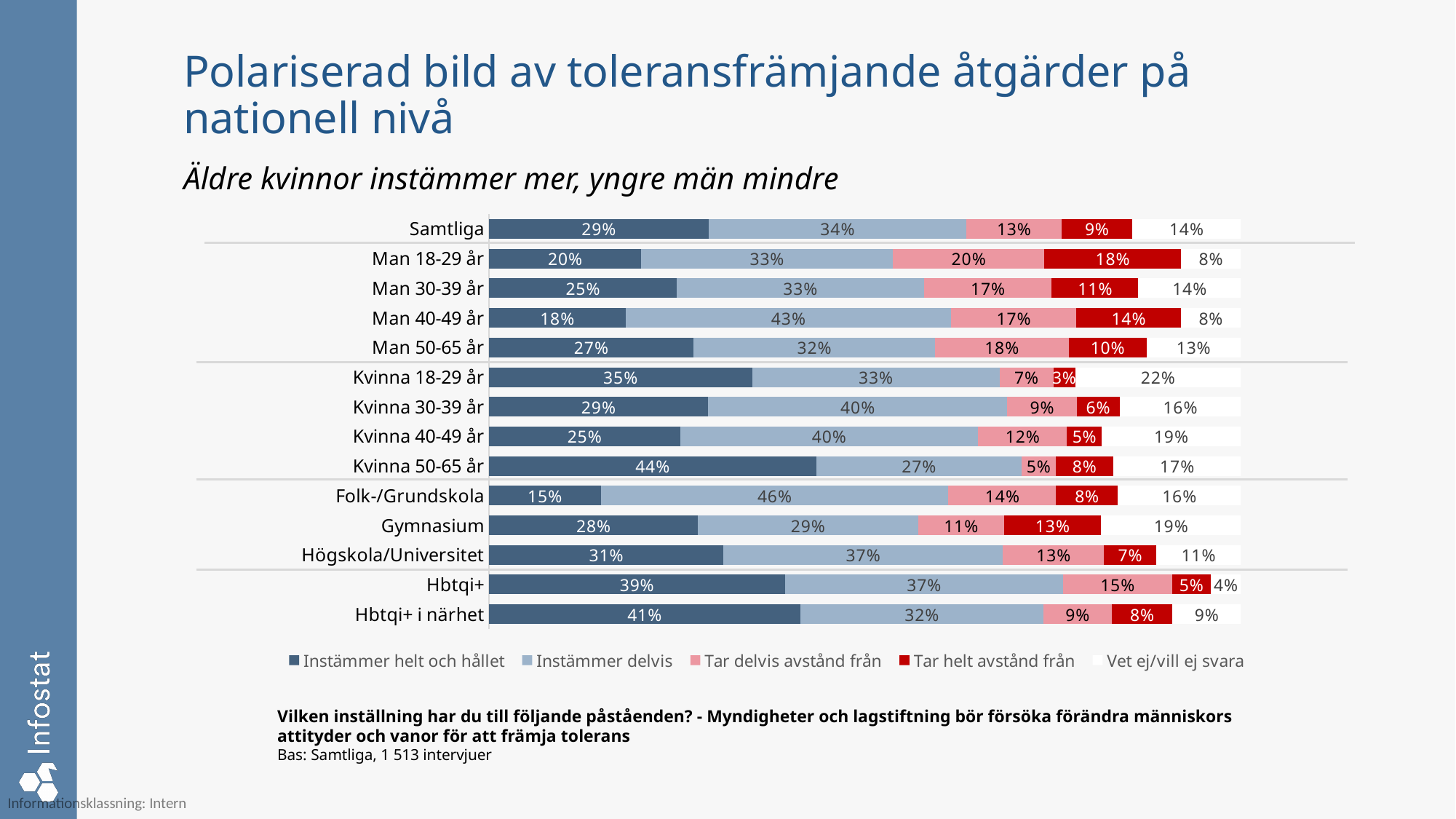
Which category has the lowest 'Instämmer helt och hållet' value? Folk-/Grundskola What is the total of all segments in the Kvinna 18-29 år bar? 100% What is the 'Vet ej/vill ej svara' value for Kvinna 18-29 år? 22% What is the difference in 'Instämmer helt och hållet' between Kvinna 50-65 år and Man 18-29 år? 24 percentage points How many series does the legend list? 5 What is the 'Tar helt avstånd från' value for Man 18-29 år? 18% How many categories (rows) are plotted in the chart? 14 What type of chart is shown on the slide? Stacked bar chart Which category has the highest 'Instämmer delvis' value? Folk-/Grundskola Which has a larger 'Instämmer delvis' value, Man 40-49 år or Man 50-65 år? Man 40-49 år What is the 'Instämmer helt och hållet' value for Samtliga? 29% Which category has the highest 'Instämmer helt och hållet' value? Kvinna 50-65 år